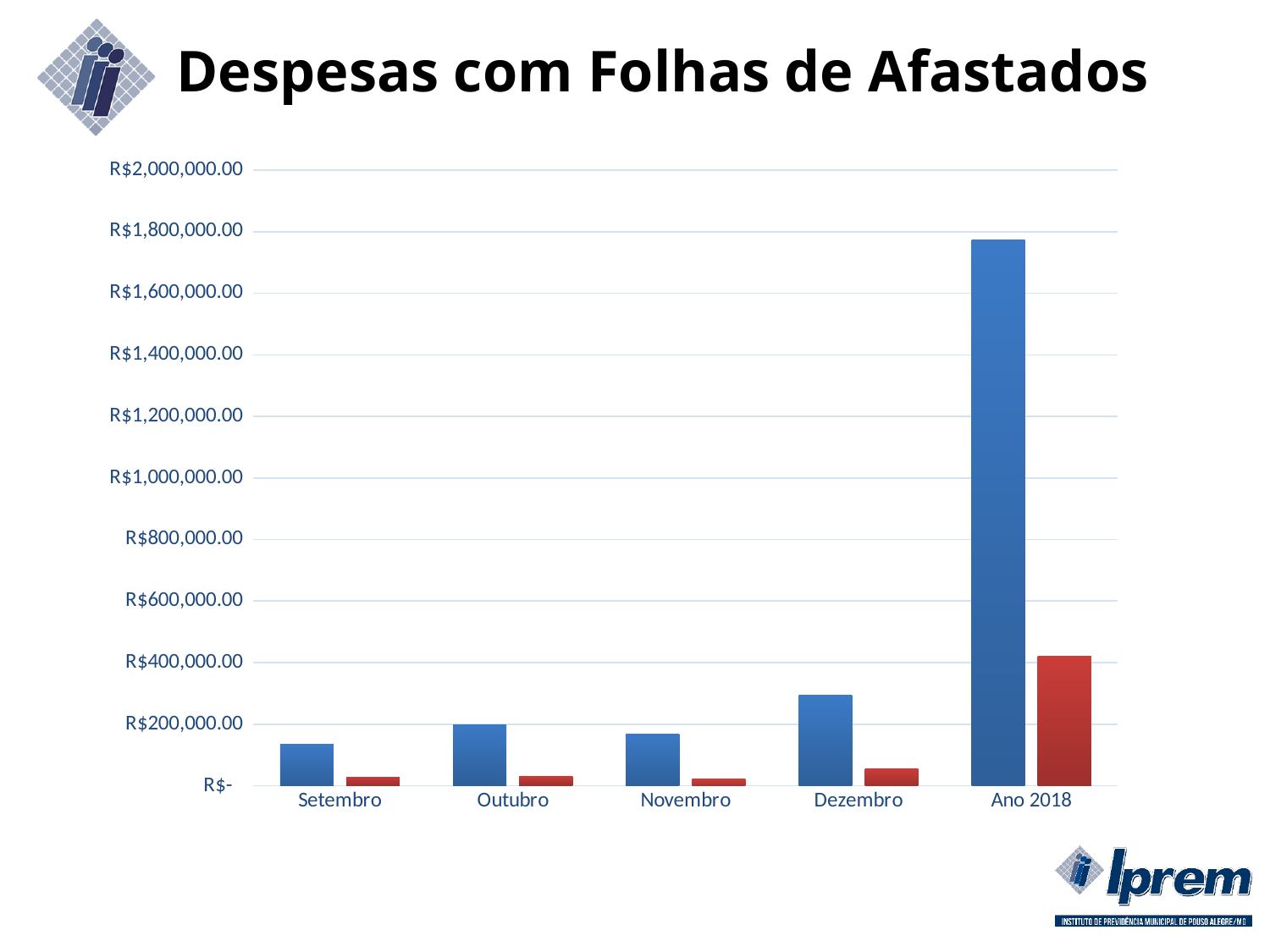
Is the blue bar for Ano 2018 greater or less than R$1,600,000.00? greater What kind of chart is shown on the slide? Bar chart What is the title of the chart? Despesas com Folhas de Afastados Which category has the tallest blue bar? Ano 2018 Is the blue bar for Setembro greater or less than R$200,000.00? less How many bars are plotted for each category in the chart? 2 Which is larger, the blue bar for Dezembro or the blue bar for Outubro? Dezembro Is the red bar for Ano 2018 greater or less than R$600,000.00? less What is the highest value shown on the vertical axis of the chart? R$2,000,000.00 How many categories are shown on the x axis of the chart? 5 Which category has the shortest blue bar? Setembro